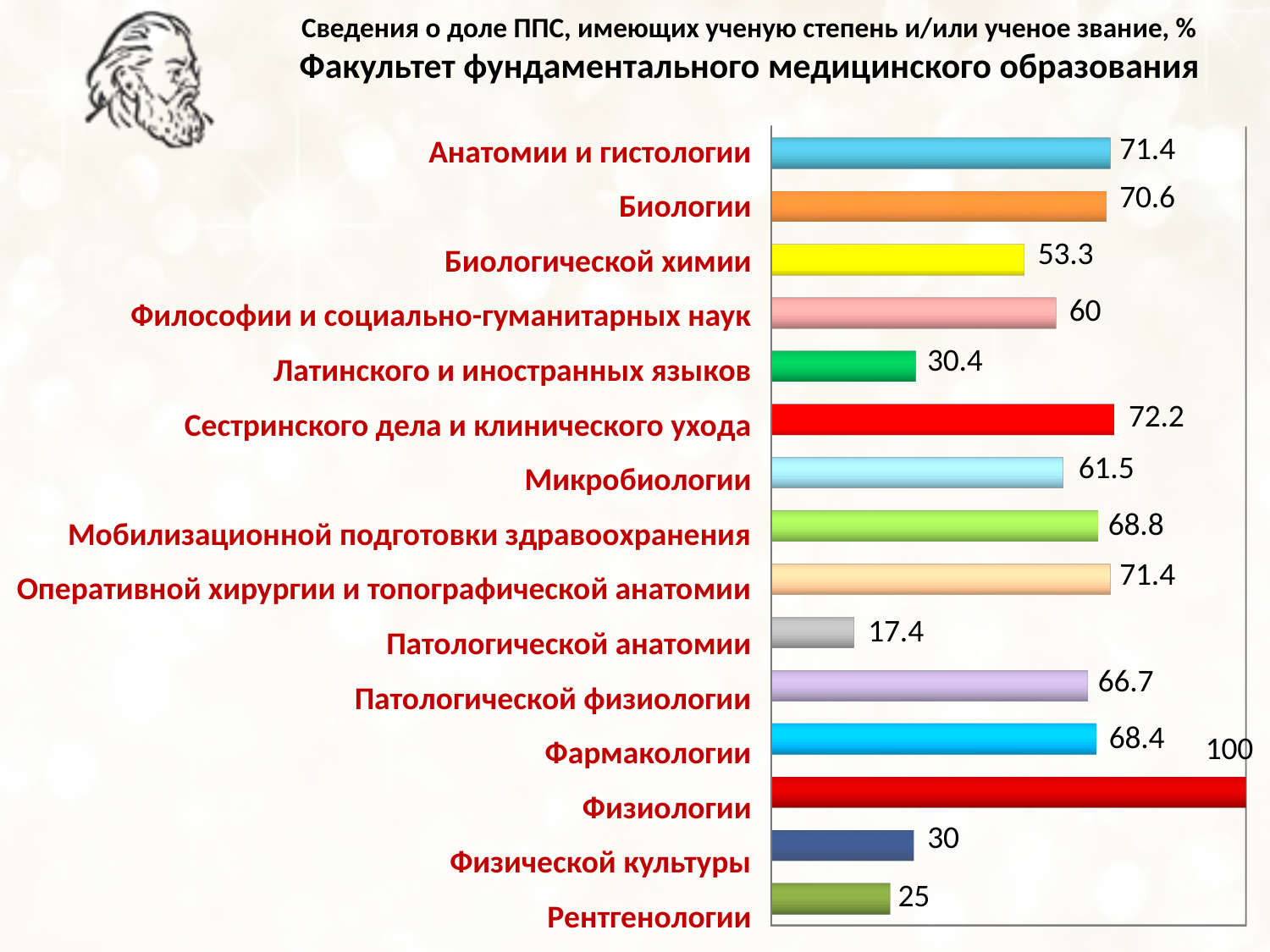
What is the value for Анатомии и гистологии? 71.4 What is the value for Сестринского дела и клинического ухода? 72.2 Which faculty is named in the chart title? Факультет фундаментального медицинского образования How many departments are shown in the chart? 15 What is the difference between the values for Физиологии and Физической культуры? 70 What type of chart is shown on the slide? Bar chart Which is larger, the value for Биологической химии or the value for Микробиологии? Микробиологии Which department has the lowest value? Патологической анатомии What is the value for Патологической анатомии? 17.4 Which department has the highest value? Физиологии What is the difference between the values for Биологии and Латинского и иностранных языков? 40.2 What is the value for Рентгенологии? 25